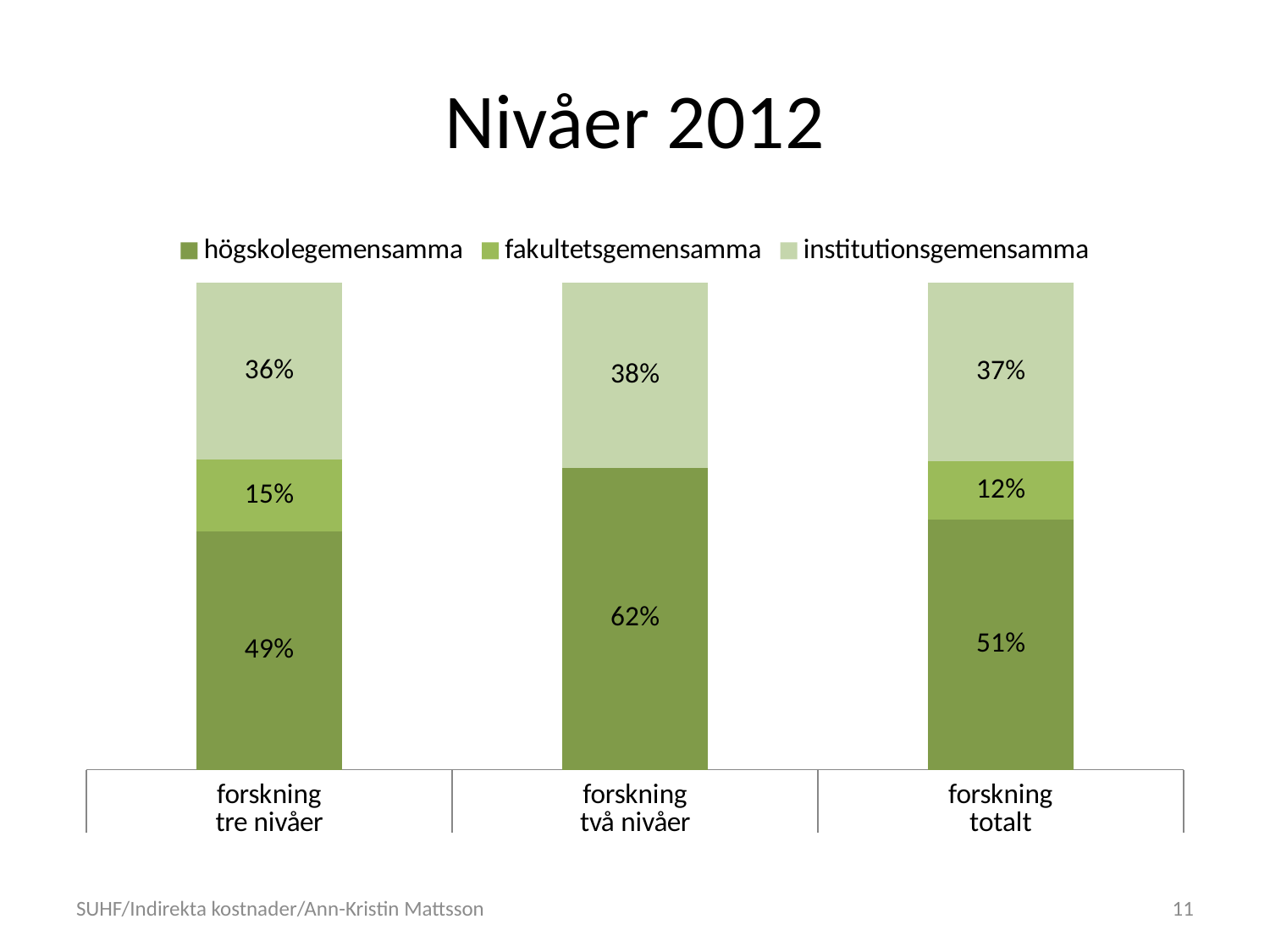
How many categories are shown on the x axis? 3 What is the högskolegemensamma value for forskning tre nivåer? 49% What kind of chart is shown on the slide? stacked bar chart What is the title of the chart? Nivåer 2012 What is the fakultetsgemensamma value for forskning totalt? 12% How many series does the legend list? 3 What is the difference between the högskolegemensamma values for forskning två nivåer and forskning tre nivåer? 13% Which category has the highest högskolegemensamma value? forskning två nivåer Which is larger: the fakultetsgemensamma value for forskning tre nivåer or for forskning totalt? forskning tre nivåer What is the institutionsgemensamma value for forskning totalt? 37% Which category has the lowest institutionsgemensamma value? forskning tre nivåer What is the institutionsgemensamma value for forskning två nivåer? 38%